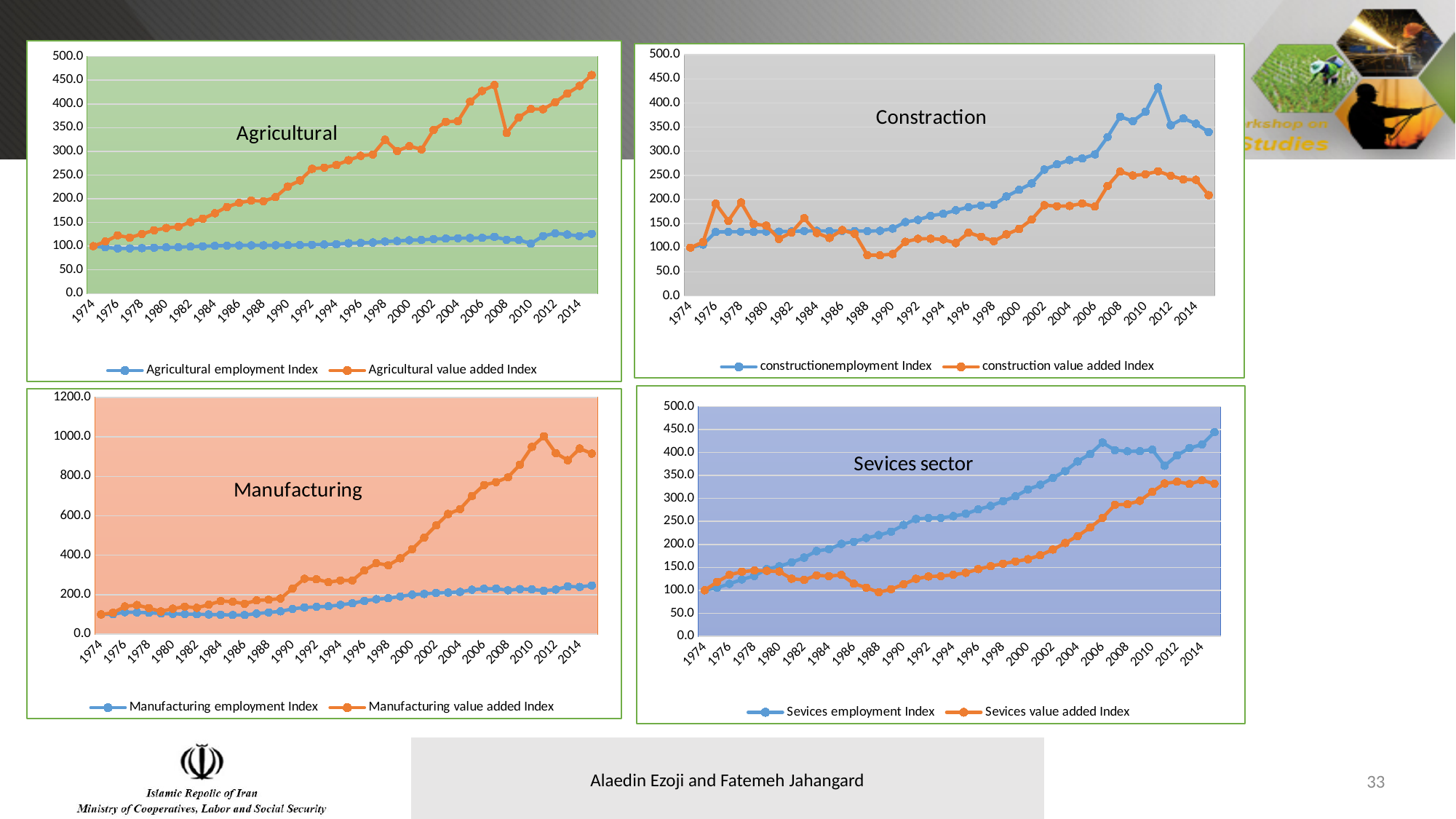
In the Agricultural chart, is the Agricultural value added Index for 2014 greater or less than 400? greater In the Agricultural chart, does the Agricultural value added Index overall rise or fall from 1974 to 2014? rise How many series does the legend of the Agricultural chart list? 2 What kind of chart is the Agricultural chart? line chart How many series does the legend of the Sevices sector chart list? 2 Which chart on the slide has a vertical axis that goes up to 1200.0? Manufacturing In the Agricultural chart, is the Agricultural employment Index for 2014 greater or less than 150? less In the Constraction chart, which series is higher in 2014, the constructionemployment Index or the construction value added Index? constructionemployment Index In the Manufacturing chart, is the Manufacturing employment Index for 2014 greater or less than 400? less